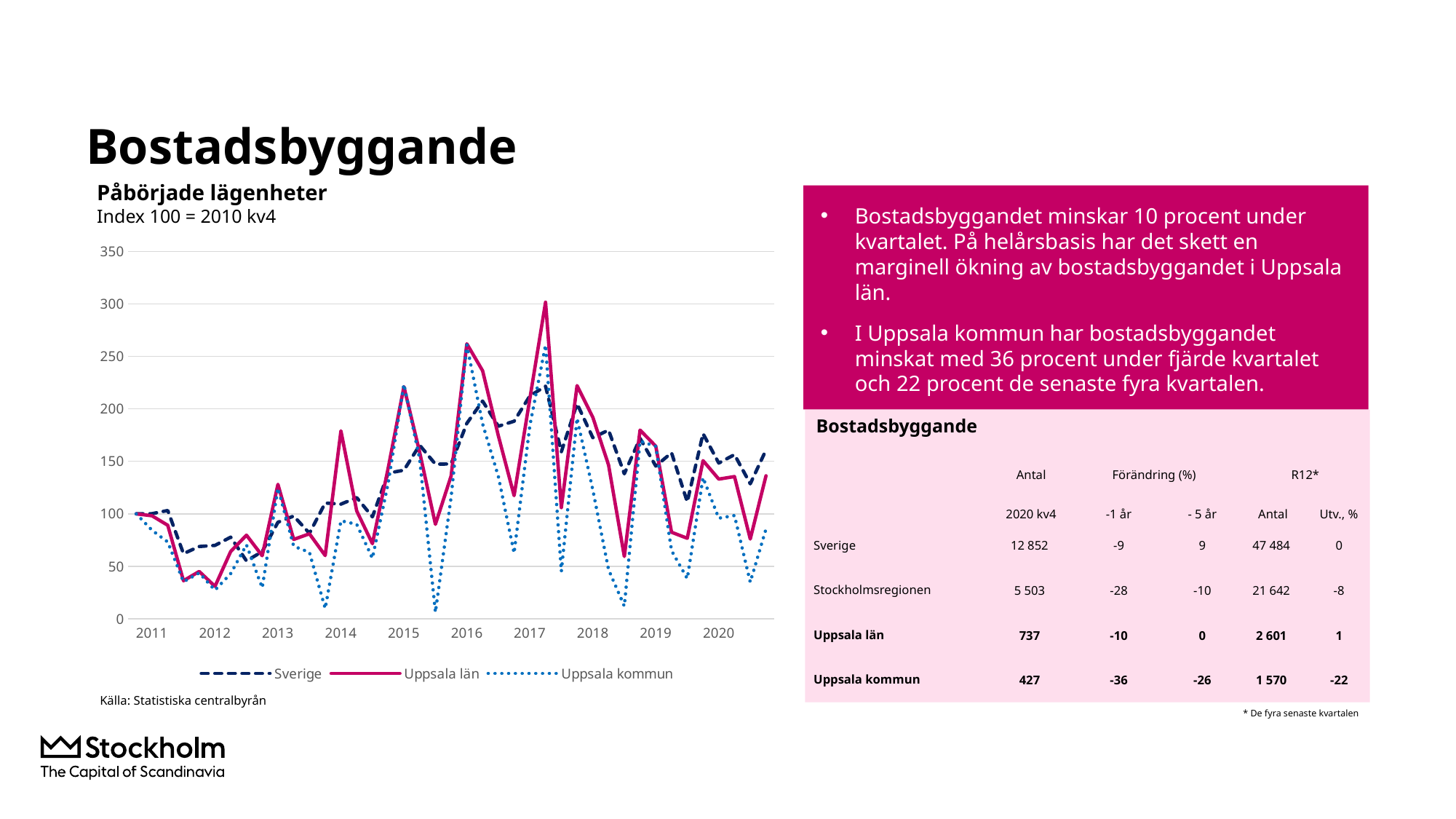
Is the peak value of Uppsala län in 2017 greater or less than 250? greater How many series does the chart legend list? 3 Is the highest value reached by Sverige greater or less than 250? less What is the highest value shown on the y axis of the chart? 350 What kind of chart is shown on the slide? Line chart What source is cited below the chart? Statistiska centralbyrån Which series reaches the highest value anywhere on the chart? Uppsala län Which series falls to the lowest value anywhere on the chart? Uppsala kommun Is the lowest value of Uppsala kommun around 2015 greater or less than 50? less How many year labels are shown on the x axis of the chart? 10 At the 2017 peak, which series is higher: Uppsala län or Sverige? Uppsala län What is the title of the chart? Påbörjade lägenheter